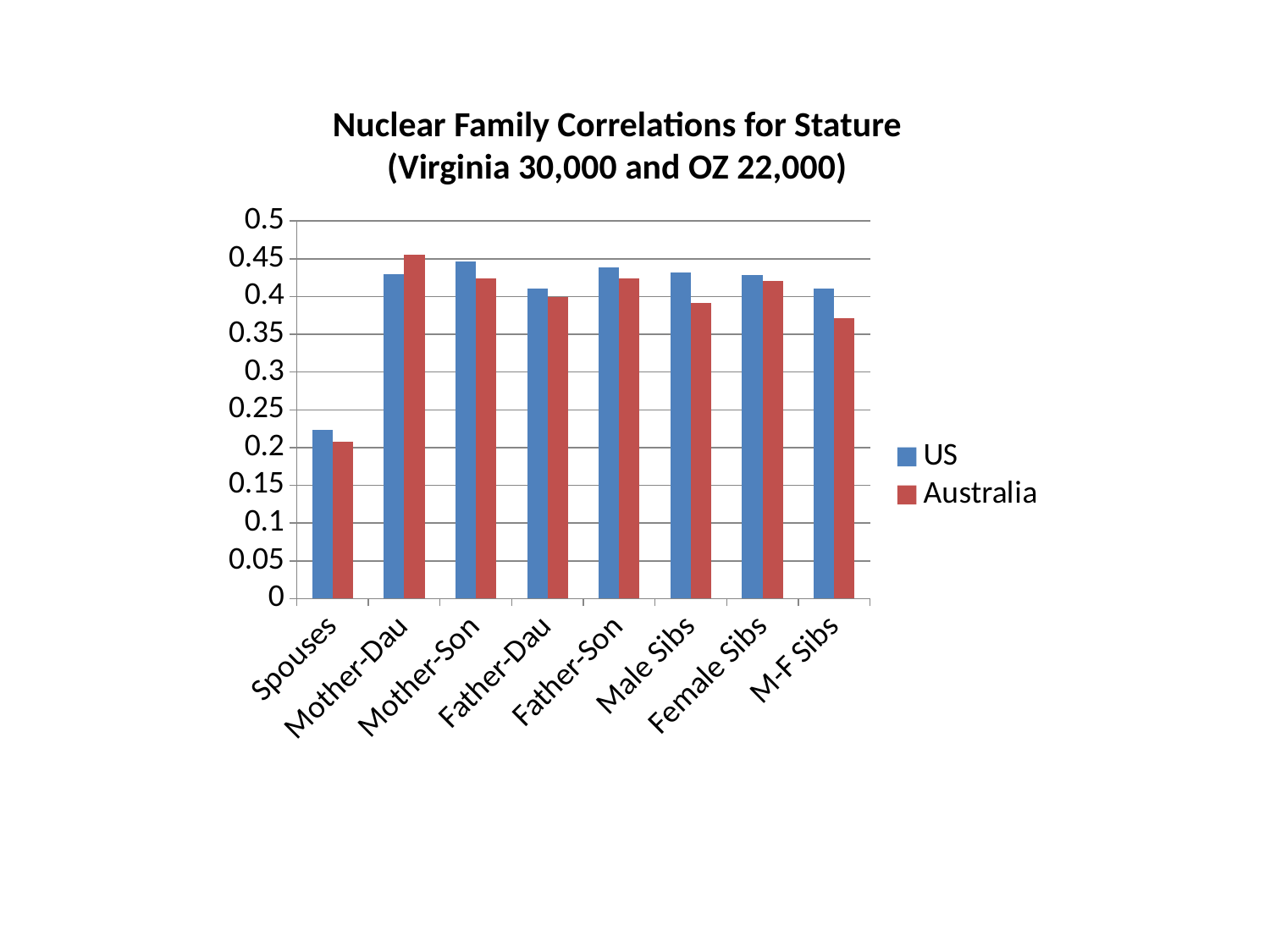
How many series does the legend list? 2 Is the US value for Spouses greater or less than 0.25? less What kind of chart is shown on the slide? bar chart What is the title of the chart? Nuclear Family Correlations for Stature (Virginia 30,000 and OZ 22,000) Is the Australia value for M-F Sibs greater or less than 0.4? less For Mother-Dau, which series has the larger value, US or Australia? Australia Which category has the lowest US correlation? Spouses Which category has the highest Australia correlation? Mother-Dau How many categories are shown on the x axis? 8 For Male Sibs, which series has the larger value, US or Australia? US For M-F Sibs, which series has the larger value, US or Australia? US Is the US value for Mother-Son greater or less than 0.4? greater